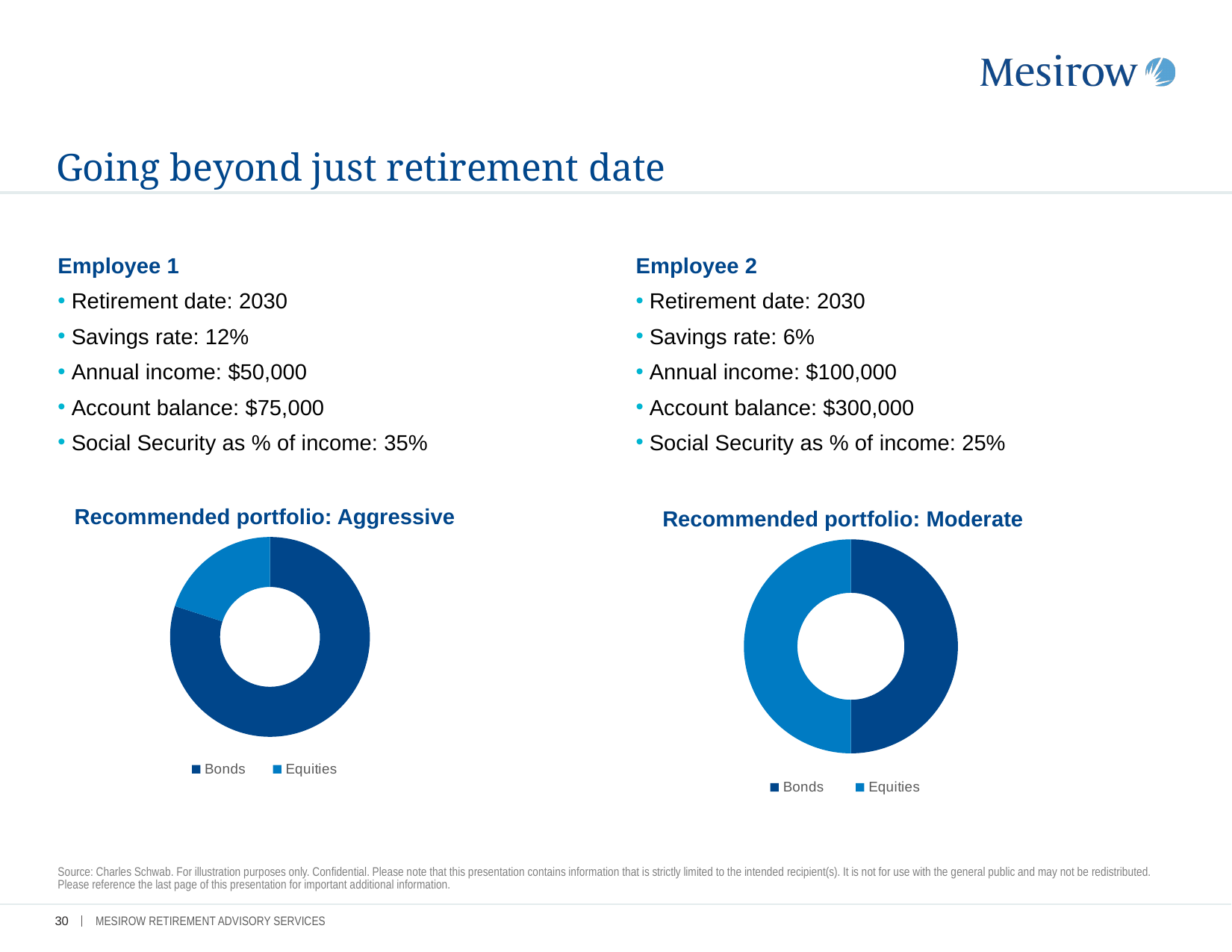
In the "Recommended portfolio: Aggressive" chart, which category has the larger slice? Bonds What kind of chart is shown under "Recommended portfolio: Aggressive"? Doughnut chart In the "Recommended portfolio: Aggressive" chart, is the Bonds slice larger or smaller than the Equities slice? Larger What are the two legend entries in the "Recommended portfolio: Moderate" chart? Bonds and Equities How many charts are shown on the slide? 2 What is the title of the chart on the left side of the slide? Recommended portfolio: Aggressive In the "Recommended portfolio: Moderate" chart, how many categories does the legend list? 2 What kind of chart is shown under "Recommended portfolio: Moderate"? Doughnut chart In the "Recommended portfolio: Aggressive" chart, which category has the smaller slice? Equities In the "Recommended portfolio: Aggressive" chart, how many categories does the legend list? 2